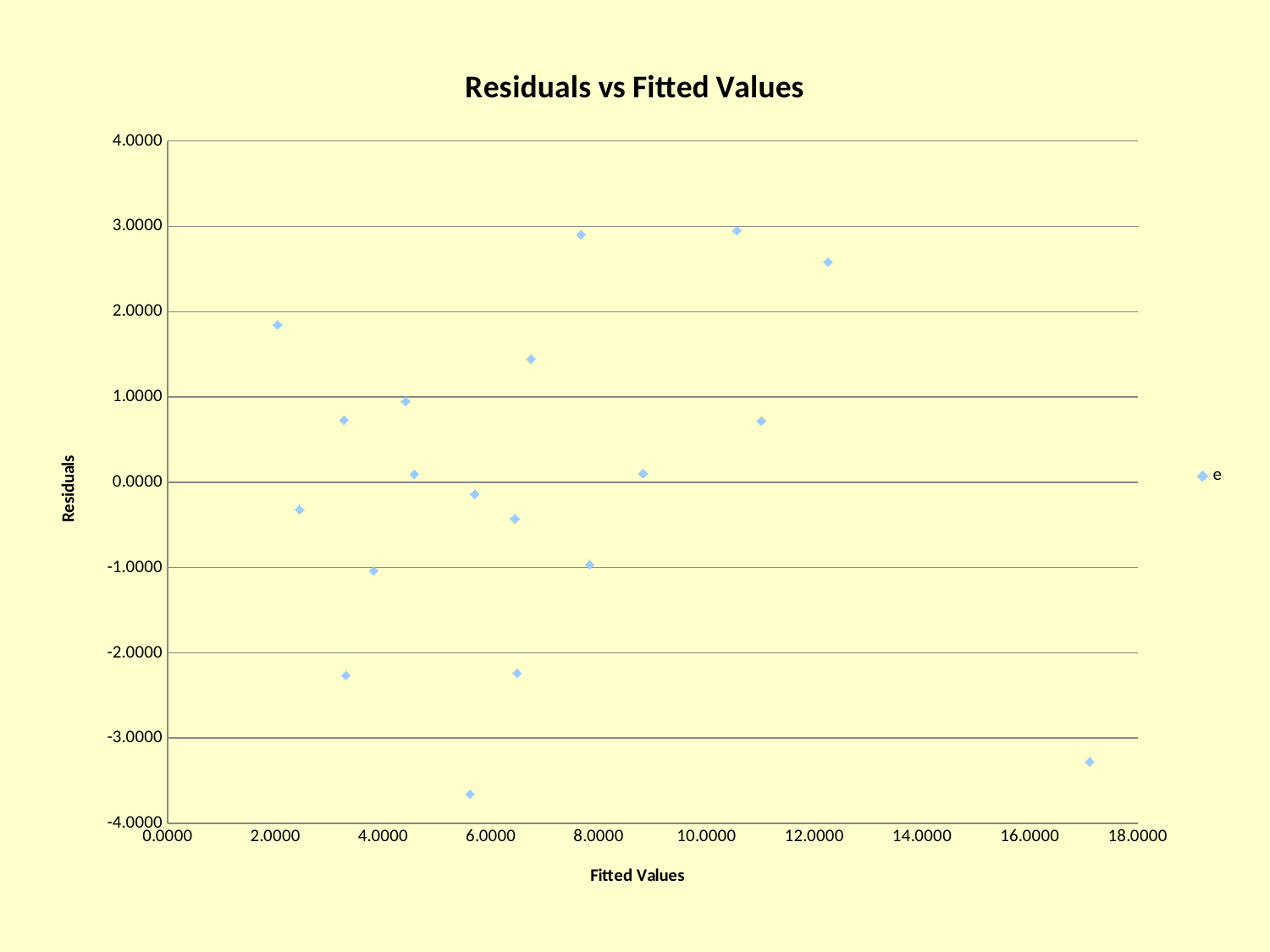
How many series does the legend list? 1 What kind of chart is shown on the slide? scatter plot Is the residual for the point with a fitted value near 2.0 greater or less than 1.0000? greater What is the name of the series shown in the legend? e Is the residual for the point with the largest fitted value (near 17) greater or less than -3.0000? less Is the residual for the point with a fitted value near 12.3 greater or less than 3.0000? less How many data points are plotted on the chart? 19 What is the title of the chart? Residuals vs Fitted Values Which point has the lowest residual: the one with a fitted value near 5.6 or the one with a fitted value near 17.1? the one near 5.6 Which has the larger residual: the point with a fitted value near 6.7 or the point with a fitted value near 7.7? the point near 7.7